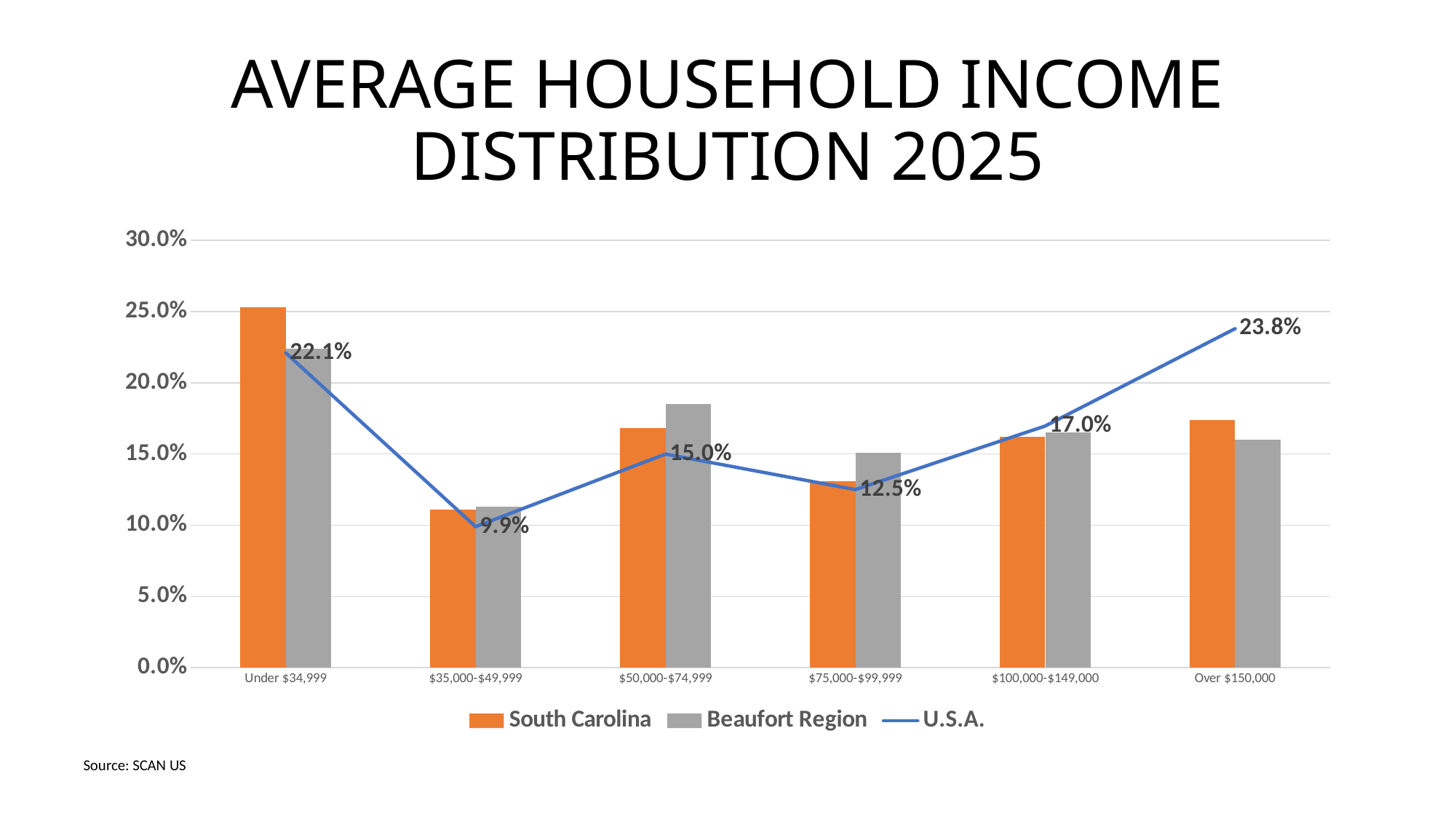
What is the U.S.A. value for the Under $34,999 income bracket? 22.1% Which income bracket has the highest South Carolina value? Under $34,999 What is the U.S.A. value for the Over $150,000 income bracket? 23.8% Which income bracket has the lowest U.S.A. value? $35,000-$49,999 What is the U.S.A. value for the $100,000-$149,000 income bracket? 17.0% Is the Beaufort Region value for $50,000-$74,999 greater or less than 15.0%? greater How many income brackets are shown on the x axis? 6 What is the U.S.A. value for the $35,000-$49,999 income bracket? 9.9% Which income bracket has the highest U.S.A. value? Over $150,000 How many series does the legend list? 3 For the U.S.A. series, which is larger: $50,000-$74,999 or $75,000-$99,999? $50,000-$74,999 What is the difference between the U.S.A. values for Over $150,000 and $35,000-$49,999? 13.9 percentage points